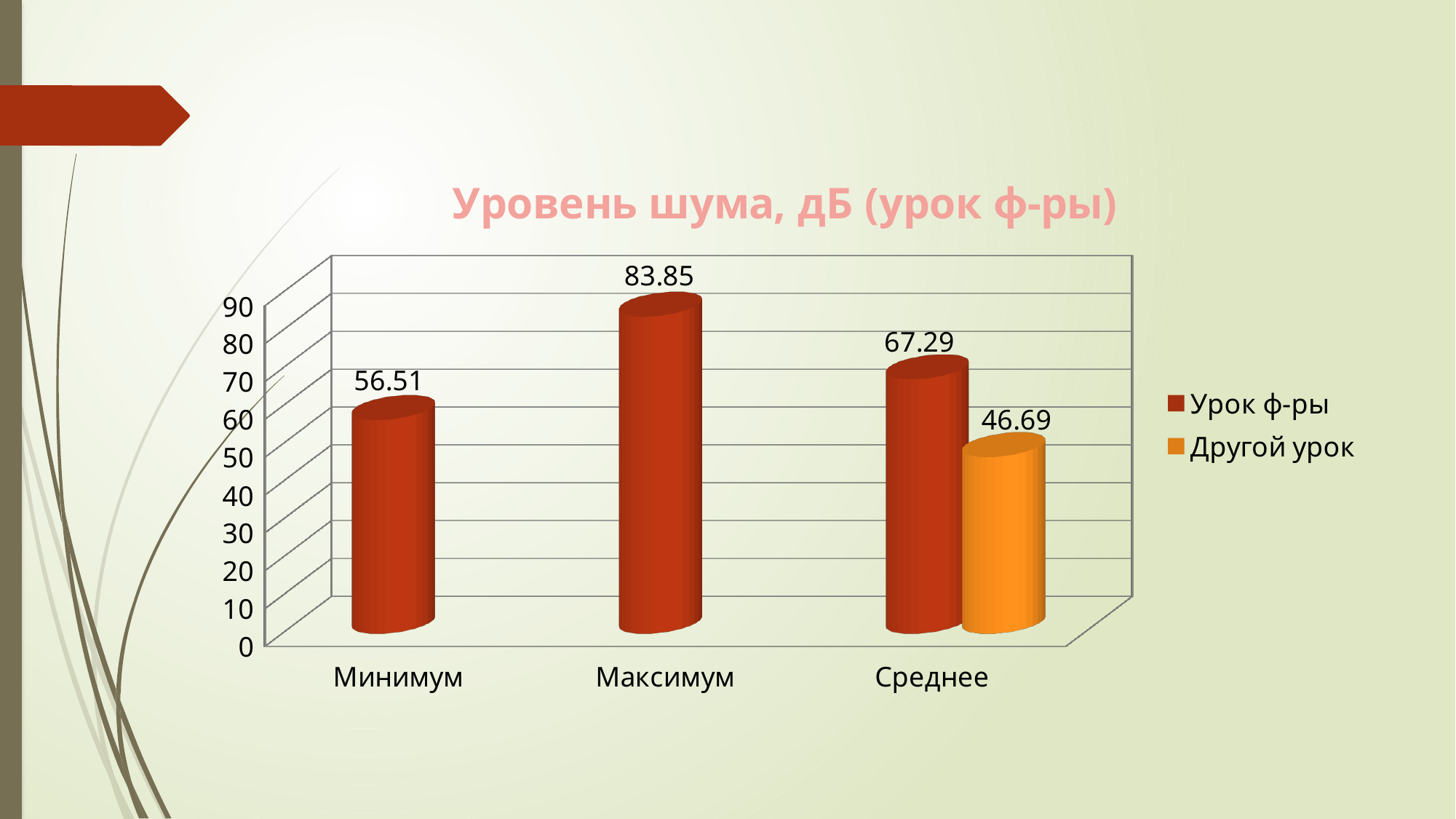
How many categories are shown on the x axis? 3 What is the value for Минимум in the Урок ф-ры series? 56.51 What is the value for Среднее in the Другой урок series? 46.69 Which category has the highest value in the Урок ф-ры series? Максимум What is the difference between the Максимум and Минимум values in the Урок ф-ры series? 27.34 What is the value for Максимум in the Урок ф-ры series? 83.85 How many series does the legend list? 2 What kind of chart is shown on the slide? Bar chart Which category has the lowest value in the Урок ф-ры series? Минимум What is the title of the chart? Уровень шума, дБ (урок ф-ры) What is the value for Среднее in the Урок ф-ры series? 67.29 For Среднее, which series has the larger value: Урок ф-ры or Другой урок? Урок ф-ры